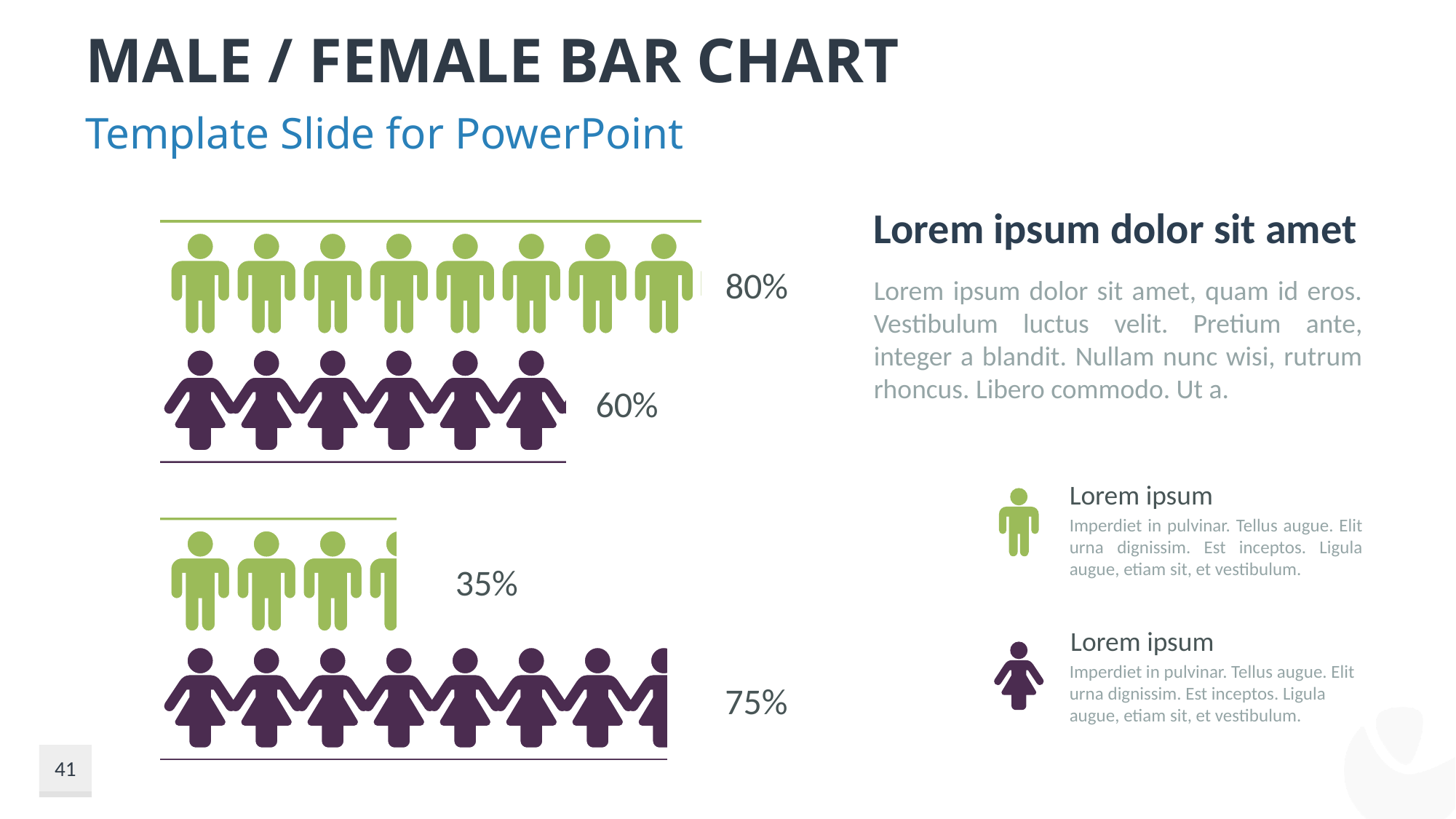
What colour are the male figures in the charts? Green Across both charts on the slide, which row has the highest percentage? Male in the top chart (80%) In the bottom chart, which group has the higher percentage, male or female? Female In the bottom chart, what percentage is shown for the male (green) figures? 35% In the bottom chart, what percentage is shown for the female (purple) figures? 75% In the top chart, what is the difference between the male and female percentages? 20% Across both charts on the slide, which row has the lowest percentage? Male in the bottom chart (35%) In the top chart, what percentage is shown for the male (green) figures? 80% In the bottom chart, what is the difference between the female and male percentages? 40% In the top chart, what percentage is shown for the female (purple) figures? 60% In the top chart, which group has the higher percentage, male or female? Male How many percentage values are shown in total across the two charts? 4